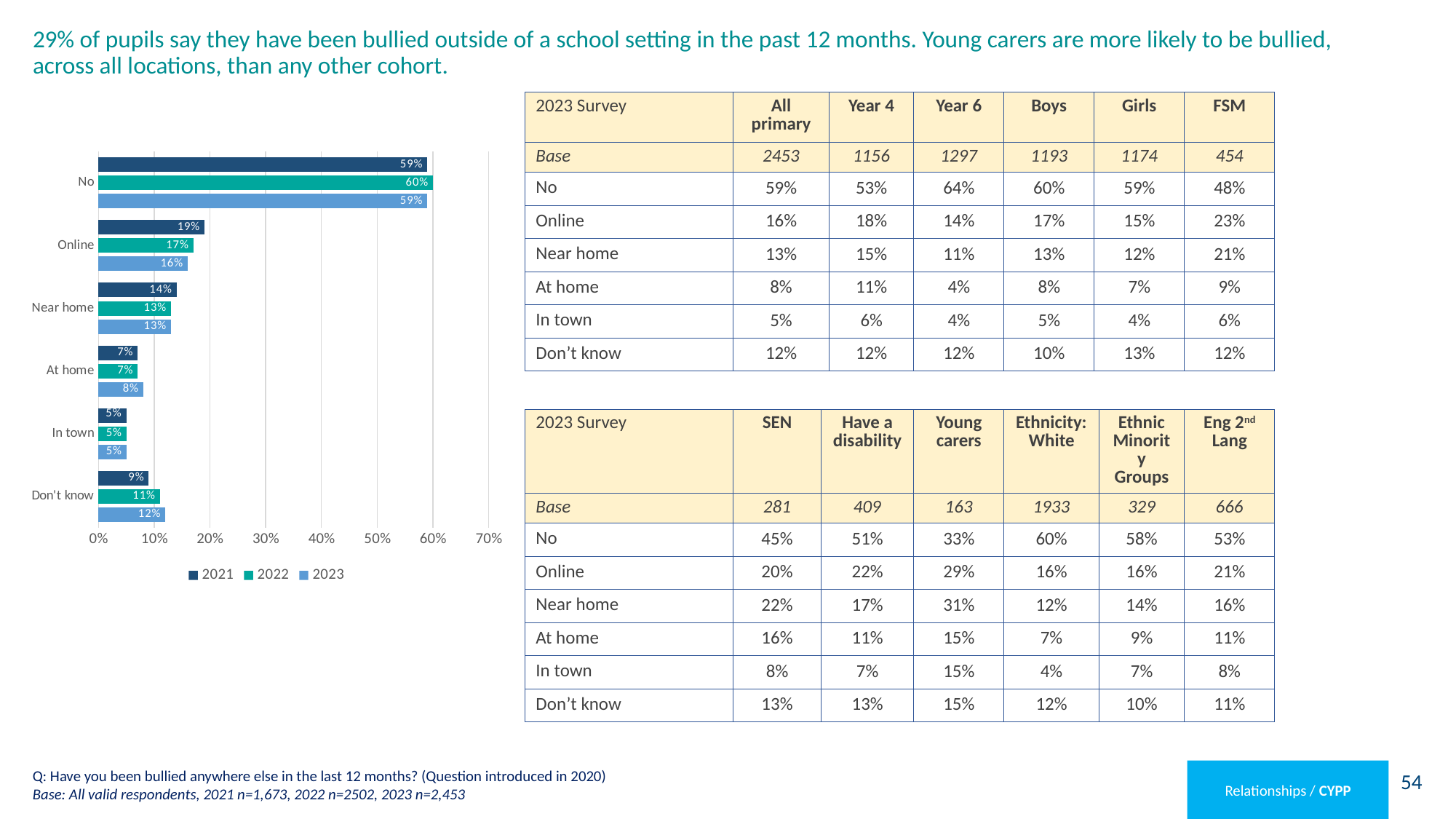
What is the 2023 value for 'Don't know' in the chart? 12% What is the 2021 value for 'Online' in the chart? 19% What is the 2022 value for 'No' in the chart? 60% How many categories are shown on the chart's vertical axis? 6 Which series in the chart legend is shown in dark navy blue? 2021 Which category has the lowest values in the chart? In town Which category has the highest values in the chart? No What kind of chart is shown on the left of the slide? bar chart How many series does the chart legend list? 3 Is the 2023 value for 'No' greater or less than 50%? greater What is the difference between the 2021 and 2023 values for 'Online'? 3% Which is larger for 'Don't know': the 2021 value or the 2023 value? 2023